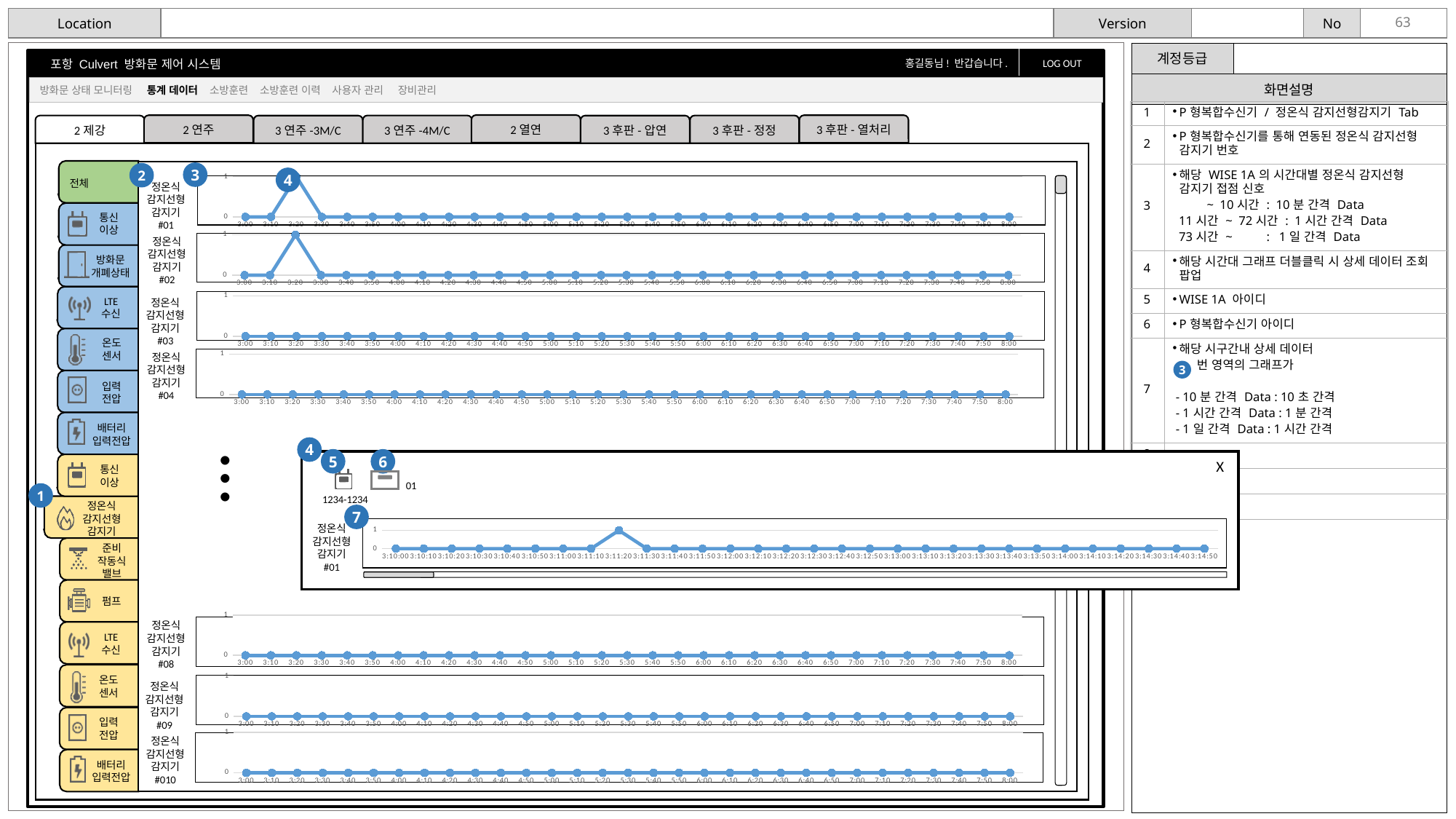
What is the last time label on the x axis of the popup chart for 정온식 감지선형 감지기 #01? 3:14:50 What kind of chart is used for the 정온식 감지선형 감지기 #01 panel? line chart In the 정온식 감지선형 감지기 #02 chart, at which time does the value reach 1? 3:20 In the popup chart for 정온식 감지선형 감지기 #01 (with second-level times), at which time does the value spike to 1? 3:11:20 What is the highest tick shown on the y axis of the 정온식 감지선형 감지기 #02 chart? 1 In the 정온식 감지선형 감지기 #01 chart, which is larger: the value at 3:20 or the value at 3:30? 3:20 What is the first time label on the x axis of the 정온식 감지선형 감지기 #08 chart? 3:00 In the 정온식 감지선형 감지기 #01 chart, at which time does the value reach 1? 3:20 What is the maximum value plotted in the 정온식 감지선형 감지기 #010 chart? 0 In the 정온식 감지선형 감지기 #04 chart, what is the value at 8:00? 0 In the 정온식 감지선형 감지기 #03 chart, what is the value at 3:00? 0 Does the value in the 정온식 감지선형 감지기 #09 chart rise, fall, or stay flat from 3:00 to 8:00? stay flat